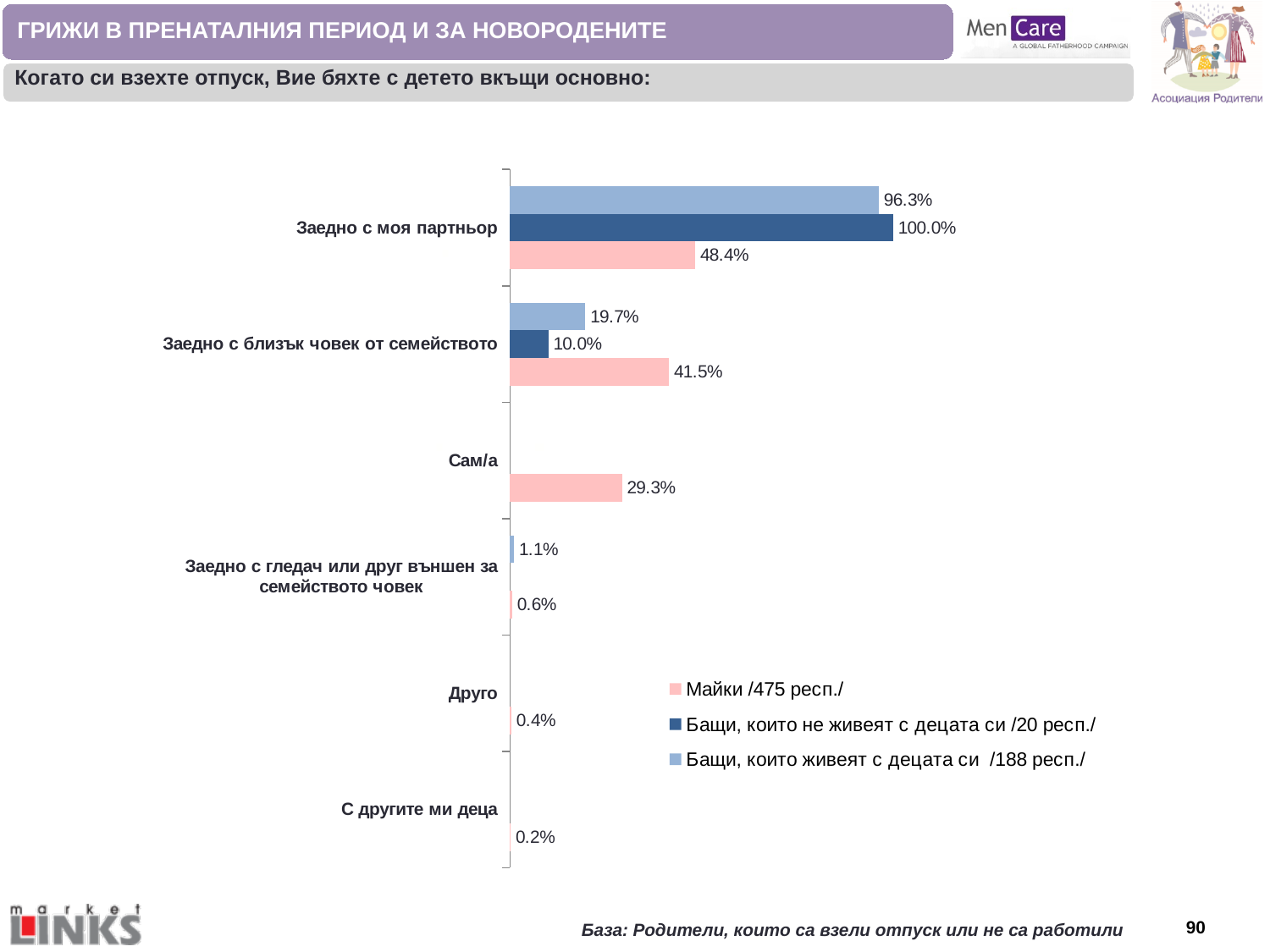
In the category Заедно с близък човек от семейството, which series has the larger value: Майки /475 респ./ or Бащи, които не живеят с децата си /20 респ./? Майки /475 респ./ How many series does the legend list? 3 What is the value for Бащи, които живеят с децата си /188 респ./ in the category Заедно с близък човек от семейството? 19.7% What is the value for Майки /475 респ./ in the category Заедно с моя партньор? 48.4% What is the value for Бащи, които не живеят с децата си /20 респ./ in the category Заедно с моя партньор? 100.0% What is the difference between the values for Бащи, които живеят с децата си /188 респ./ and Майки /475 респ./ in the category Заедно с моя партньор? 47.9% How many categories are shown on the chart? 6 What is the value for Майки /475 респ./ in the category Сам/а? 29.3% Which category has the highest value for Майки /475 респ./? Заедно с моя партньор What kind of chart is shown on the slide? bar chart What colour are the bars for the series Майки /475 респ./? pink Which category has the lowest value for Майки /475 респ./? С другите ми деца